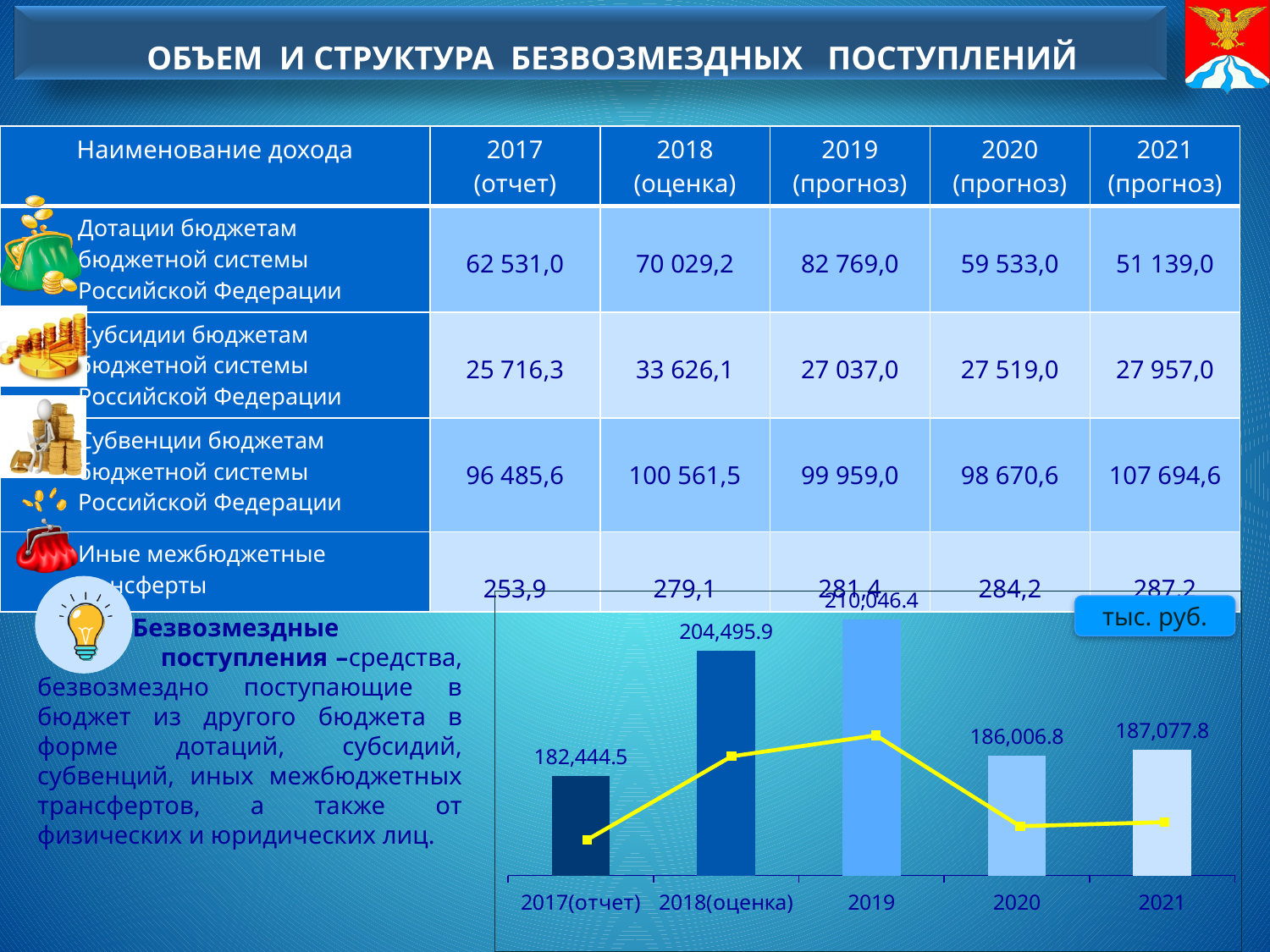
What is the value of the bar for 2020 in the chart? 186,006.8 Do the bar values rise or fall from 2017(отчет) to 2019? rise Which year has the highest bar value in the chart? 2019 How many years (categories) are shown on the x axis of the chart? 5 What is the value of the bar for 2017(отчет) in the chart? 182,444.5 What is the value of the bar for 2018(оценка) in the chart? 204,495.9 What is the value of the bar for 2021 in the chart? 187,077.8 What is the difference between the bar values for 2021 and 2020? 1,071.0 Which year has the lowest bar value in the chart? 2017(отчет) What is the value of the bar for 2019 in the chart? 210,046.4 Which bar value is larger, 2018(оценка) or 2020? 2018(оценка) What is the difference between the bar values for 2019 and 2017(отчет)? 27,601.9